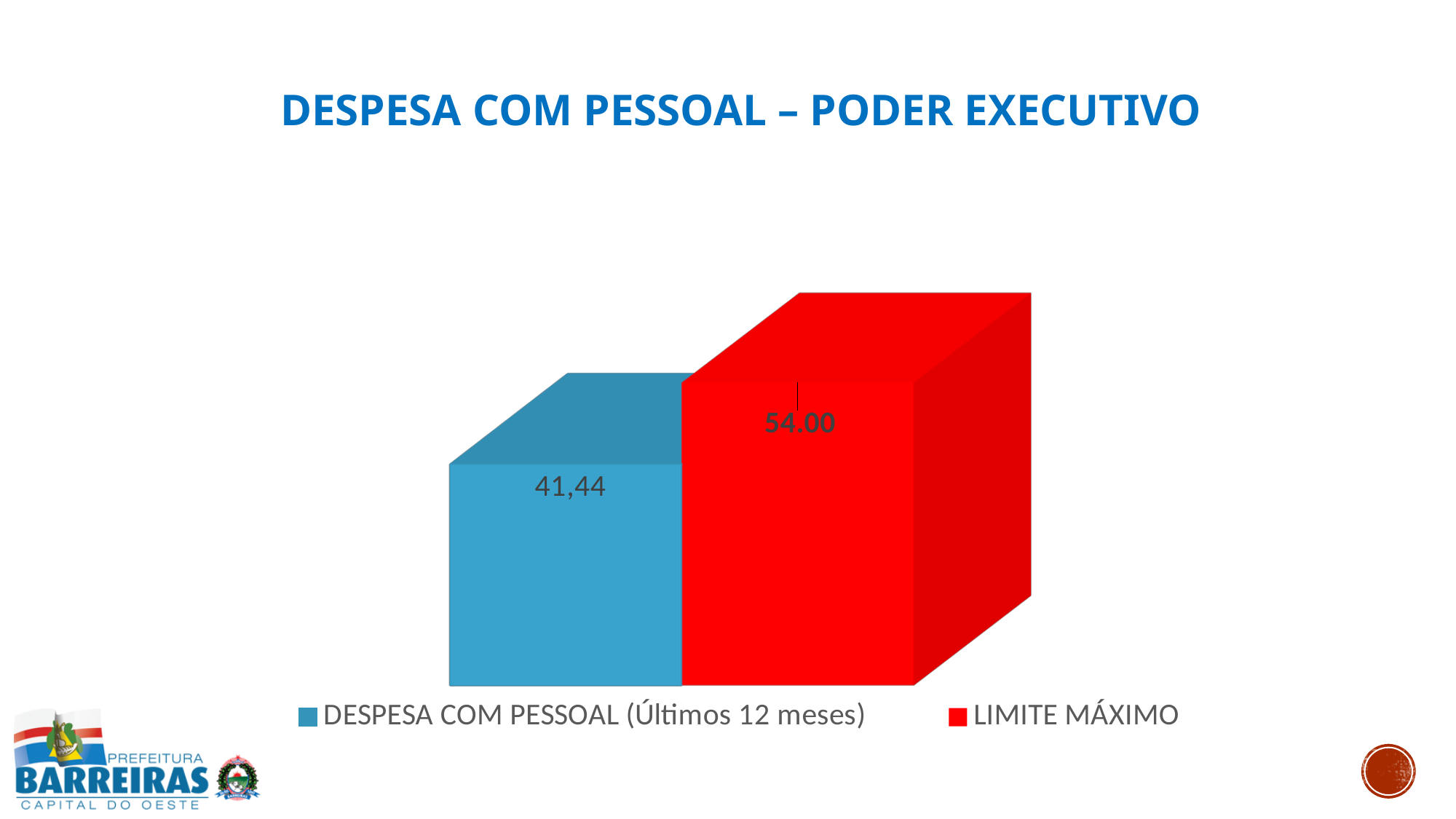
Which series has the higher value, DESPESA COM PESSOAL (Últimos 12 meses) or LIMITE MÁXIMO? LIMITE MÁXIMO Which bar shows the highest value on the chart? LIMITE MÁXIMO What kind of chart is shown on the slide? Bar chart What is the difference between the LIMITE MÁXIMO value and the DESPESA COM PESSOAL (Últimos 12 meses) value? 12,56 What is the value of the DESPESA COM PESSOAL (Últimos 12 meses) bar? 41,44 How many series does the legend list? 2 What is the title of the chart on the slide? DESPESA COM PESSOAL – PODER EXECUTIVO What is the value of the LIMITE MÁXIMO bar? 54.00 What colour is the LIMITE MÁXIMO bar? Red Which bar shows the lowest value on the chart? DESPESA COM PESSOAL (Últimos 12 meses) How many bars are plotted on the chart? 2